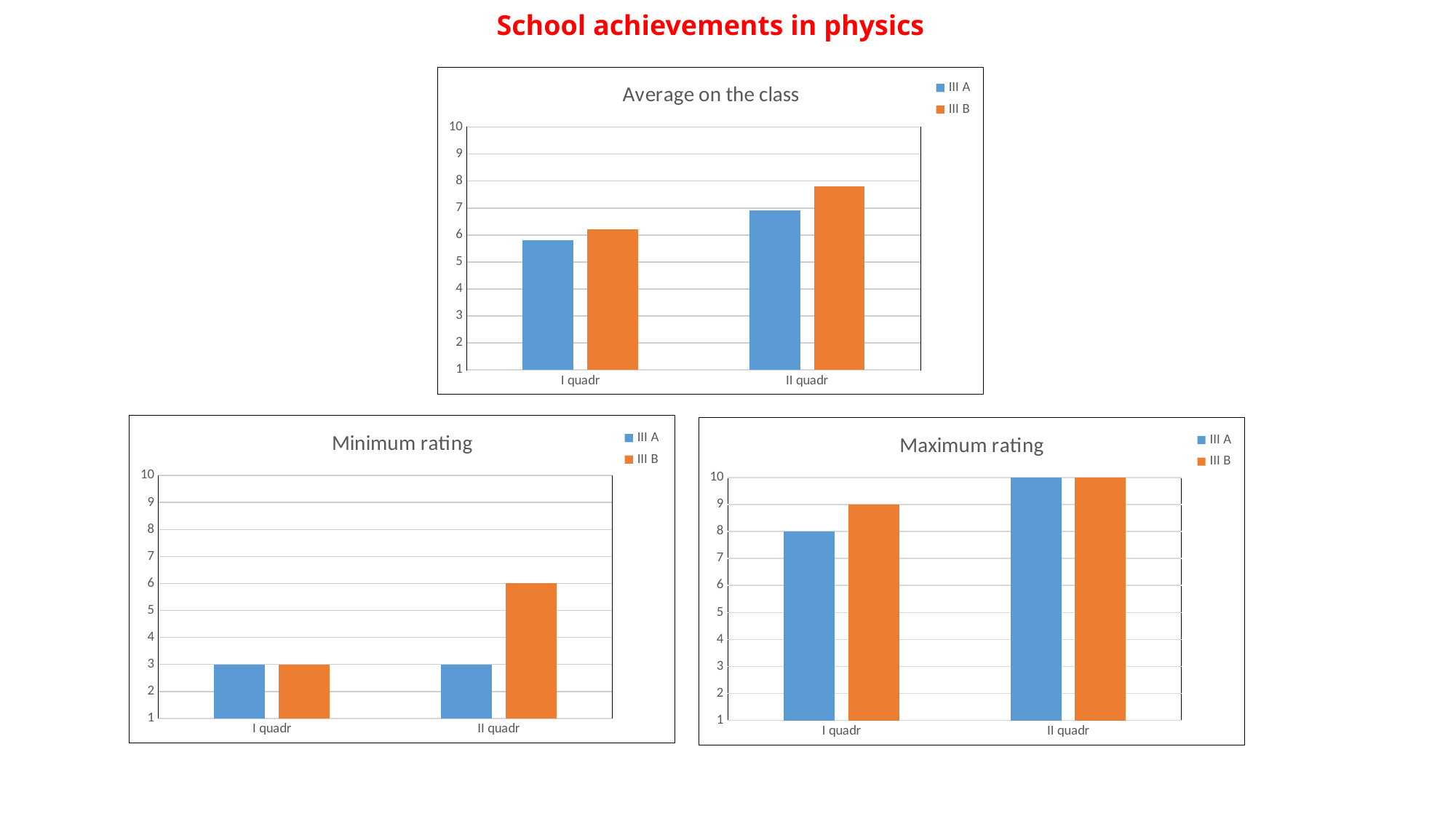
In the "Maximum rating" chart, what is the difference between III B and III A in I quadr? 1 In the "Average on the class" chart, which series has the higher value in II quadr, III A or III B? III B In the "Minimum rating" chart, what is the value for III B in II quadr? 6 What kind of chart is the "Minimum rating" chart? bar chart How many series does the legend of the "Maximum rating" chart list? 2 In the "Average on the class" chart, is the value for III A in I quadr greater or less than 6? less In the "Average on the class" chart, do the values for III A rise or fall from I quadr to II quadr? rise In the "Average on the class" chart, is the value for III B in II quadr greater or less than 7? greater In the "Maximum rating" chart, what is the value for III A in II quadr? 10 In the "Minimum rating" chart, what is the difference between III B and III A in II quadr? 3 In the "Minimum rating" chart, what is the value for III A in I quadr? 3 In the "Maximum rating" chart, what is the value for III B in I quadr? 9